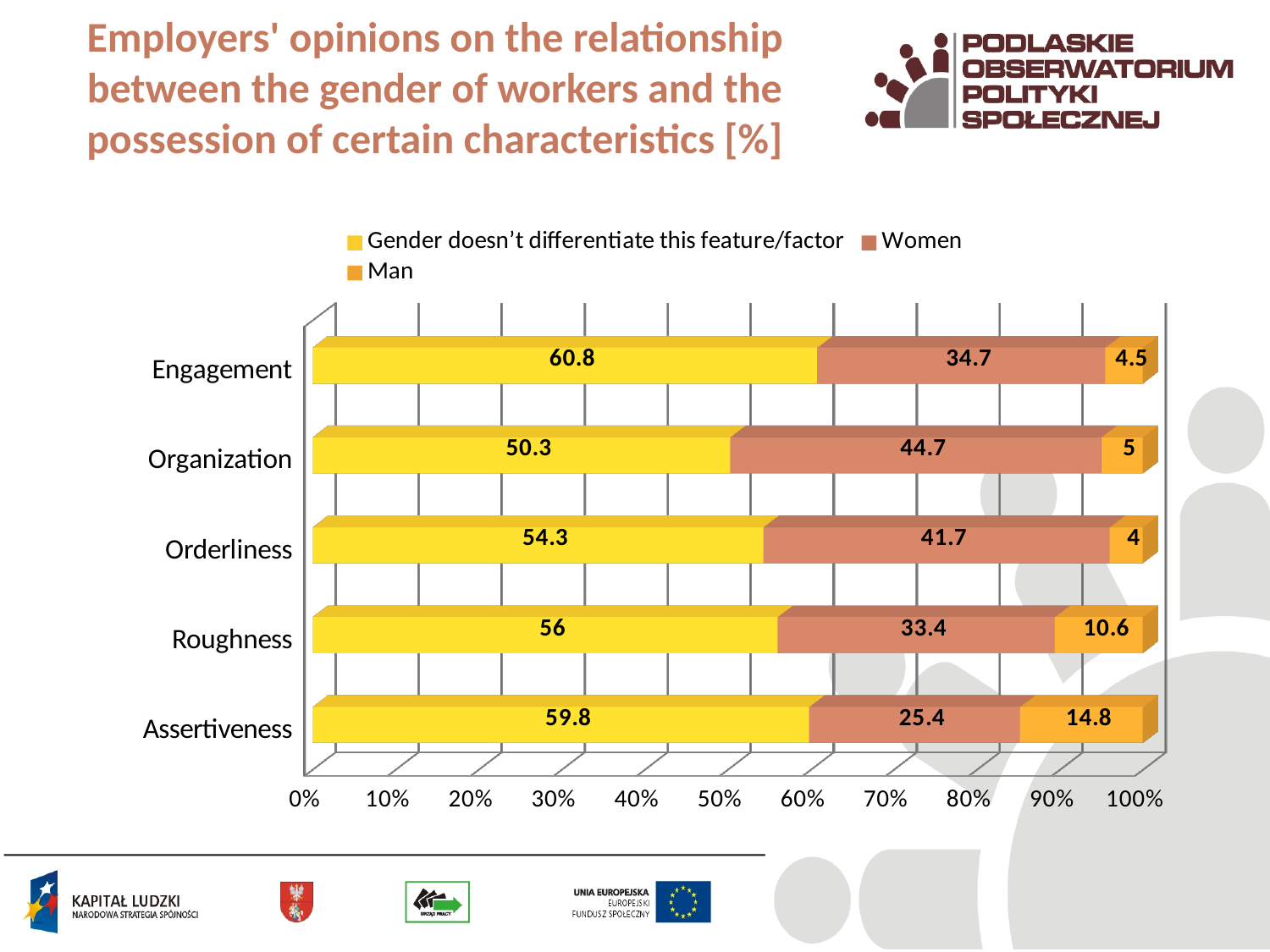
How many series does the legend list? 3 What is the difference between the Women values for Organization and Assertiveness? 19.3 What is the total of the stacked bar for Roughness? 100 What is the value for 'Gender doesn't differentiate this feature/factor' for Orderliness? 54.3 What is the value for Man for Assertiveness? 14.8 How many characteristics (categories) are plotted on the chart? 5 What is the value for Women for Organization? 44.7 Which characteristic has the lowest value for Man? Orderliness Which characteristic has the highest value for 'Gender doesn't differentiate this feature/factor'? Engagement What kind of chart is shown on the slide? Stacked bar chart Which characteristic has the highest value for Women? Organization Which is larger: the Man value for Roughness or the Man value for Engagement? Roughness